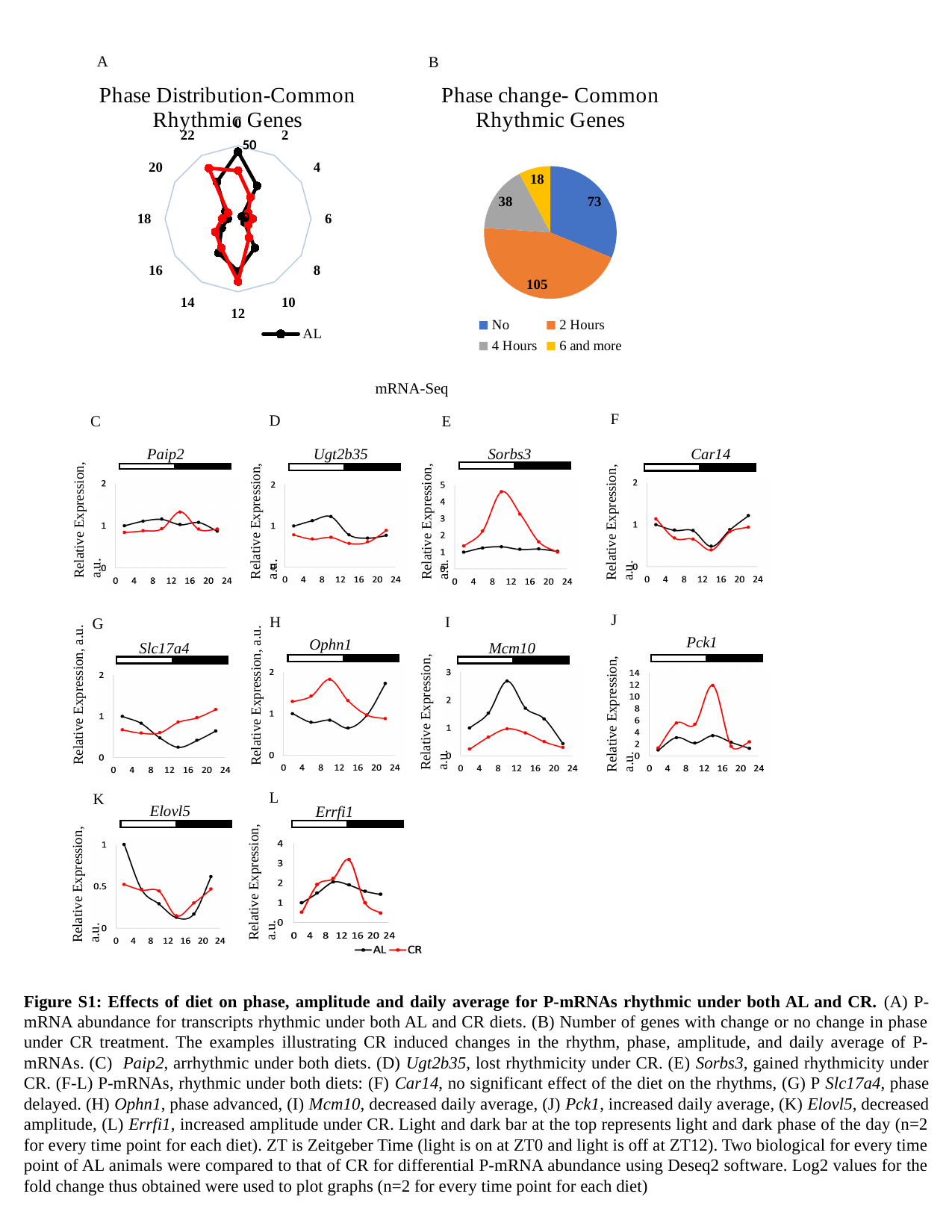
In chart E (Sorbs3), is the peak value of the CR line greater or less than 4? greater In chart J (Pck1), is the peak value of the CR line greater or less than 10? greater In the pie chart 'Phase change- Common Rhythmic Genes', which category has the largest value? 2 Hours In the pie chart 'Phase change- Common Rhythmic Genes', what is the sum of all four slice values? 234 In the pie chart 'Phase change- Common Rhythmic Genes', what is the difference between the '2 Hours' value and the 'No' value? 32 In chart I (Mcm10), which series has the higher value at ZT 10, AL or CR? AL In the pie chart 'Phase change- Common Rhythmic Genes', what is the value for the '2 Hours' slice? 105 In the pie chart 'Phase change- Common Rhythmic Genes', how many slices are there? 4 What kind of chart is chart A, 'Phase Distribution-Common Rhythmic Genes'? radar chart In the pie chart 'Phase change- Common Rhythmic Genes', which category has the smallest value? 6 and more In the pie chart 'Phase change- Common Rhythmic Genes', what is the value for the 'No' slice? 73 What kind of chart is chart B, 'Phase change- Common Rhythmic Genes'? pie chart